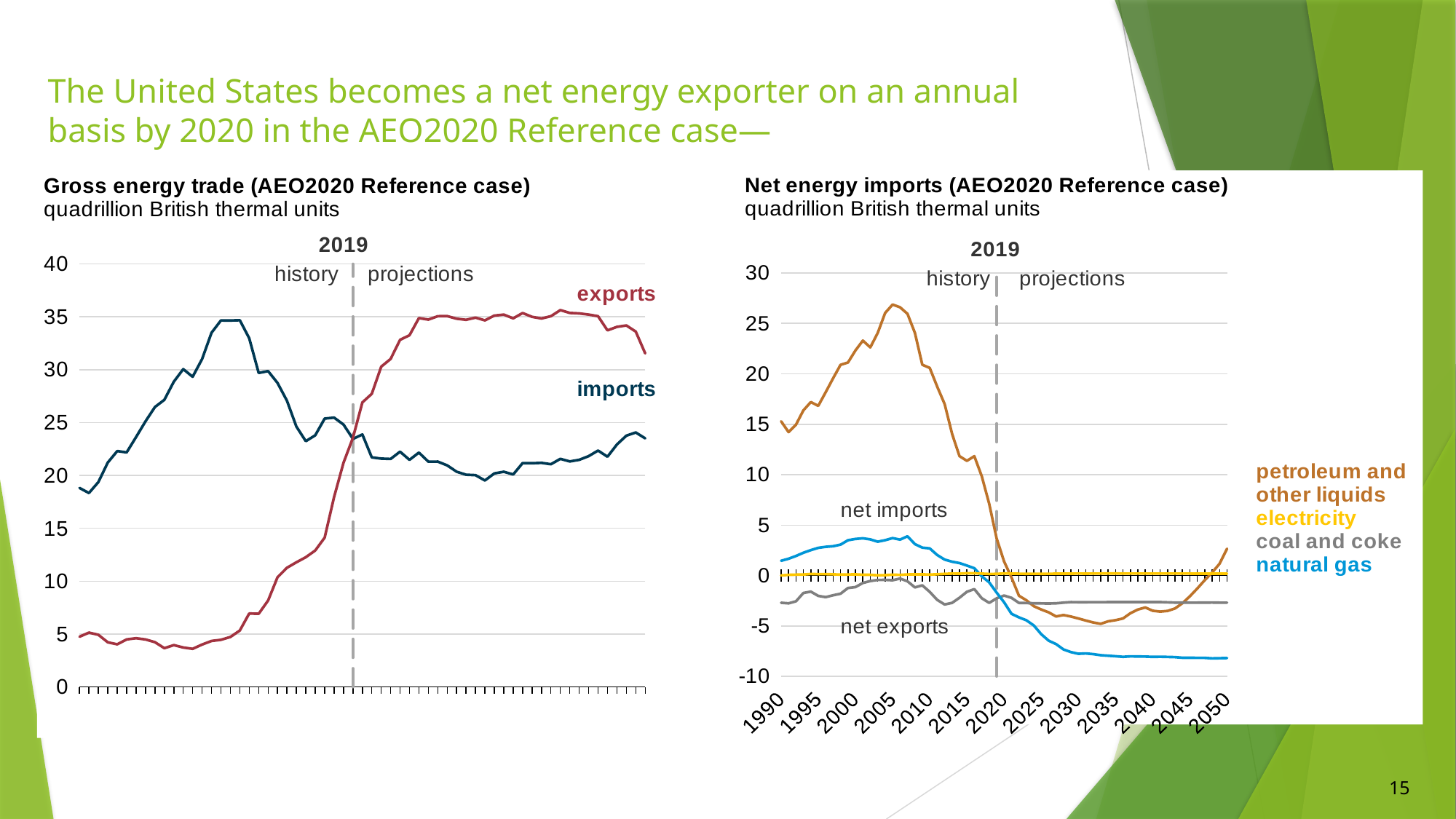
On the 'Net energy imports' chart, which series is higher in 2050, petroleum and other liquids or natural gas? petroleum and other liquids What unit is shown under the title of the 'Net energy imports (AEO2020 Reference case)' chart? quadrillion British thermal units On the 'Net energy imports' chart, does the natural gas series rise or fall over the projection period? fall What kind of chart is the 'Gross energy trade (AEO2020 Reference case)' chart on the left? line chart On the 'Gross energy trade' chart, is the peak value of imports greater or less than 30? greater How many series are plotted on the 'Gross energy trade (AEO2020 Reference case)' chart? 2 On the 'Gross energy trade' chart, which series is higher at the end of the projection period, exports or imports? exports How many series does the legend list on the 'Net energy imports (AEO2020 Reference case)' chart? 4 On the 'Net energy imports' chart, is the peak value of petroleum and other liquids greater or less than 25? greater On the 'Gross energy trade' chart, is the value of exports at the start of the series greater or less than 10? less On the 'Gross energy trade' chart, which series is higher in the history period around its peak, exports or imports? imports